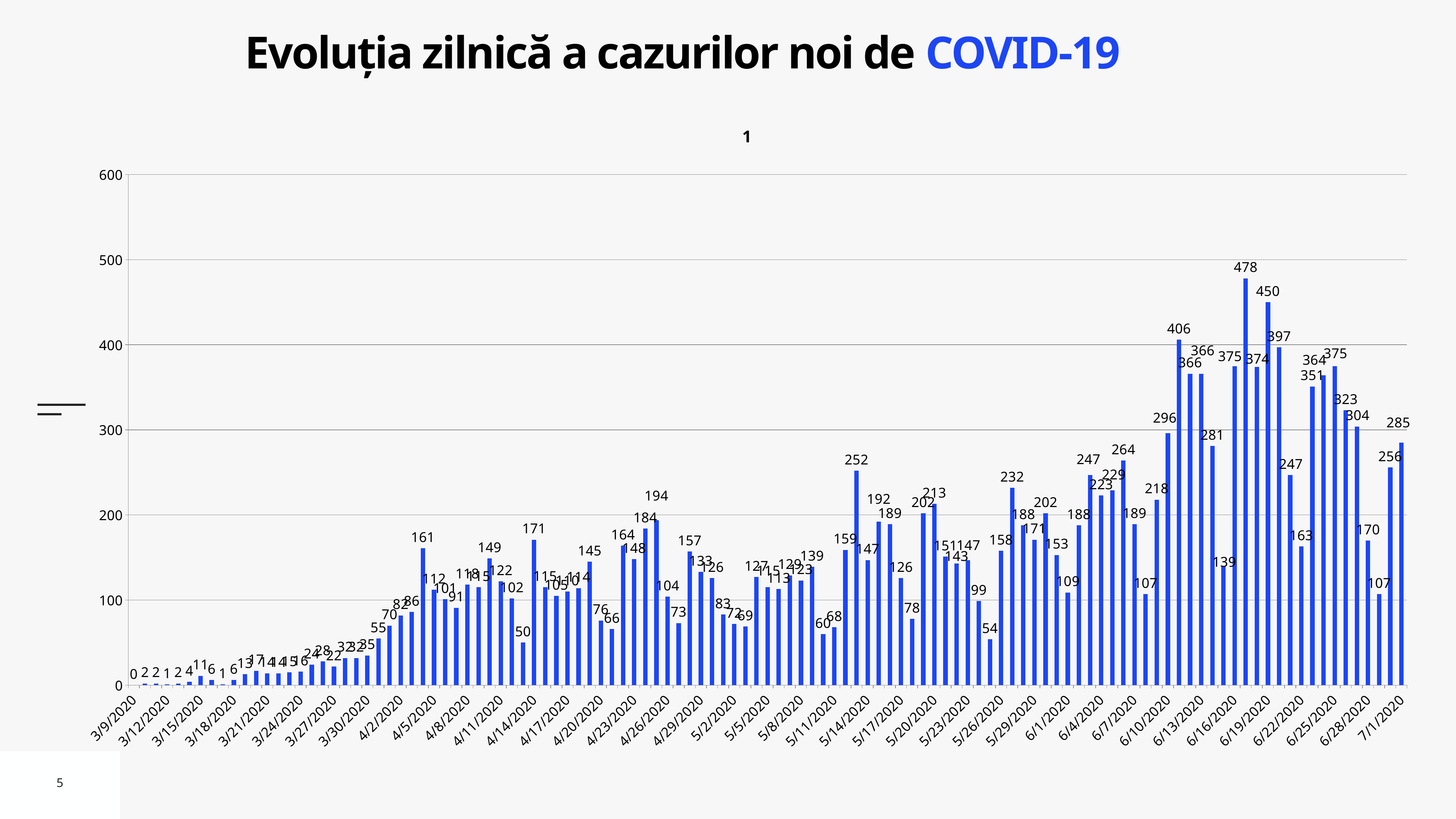
What is the value for 3/9/2020? 0 What is the highest daily value shown in the chart? 478 Which date has the larger value, 6/10/2020 or 6/13/2020? 6/13/2020 What is the value for 4/14/2020? 171 What is the value for 7/1/2020? 285 What is the value for 5/14/2020? 147 What is the difference between the values for 7/1/2020 and 6/28/2020? 115 Is the value for 6/16/2020 greater or less than 300? greater What kind of chart is shown on the slide? bar chart What is the title of the slide? Evoluția zilnică a cazurilor noi de COVID-19 What is the value for 6/19/2020? 450 Do the daily values generally rise or fall from March to the end of June? rise